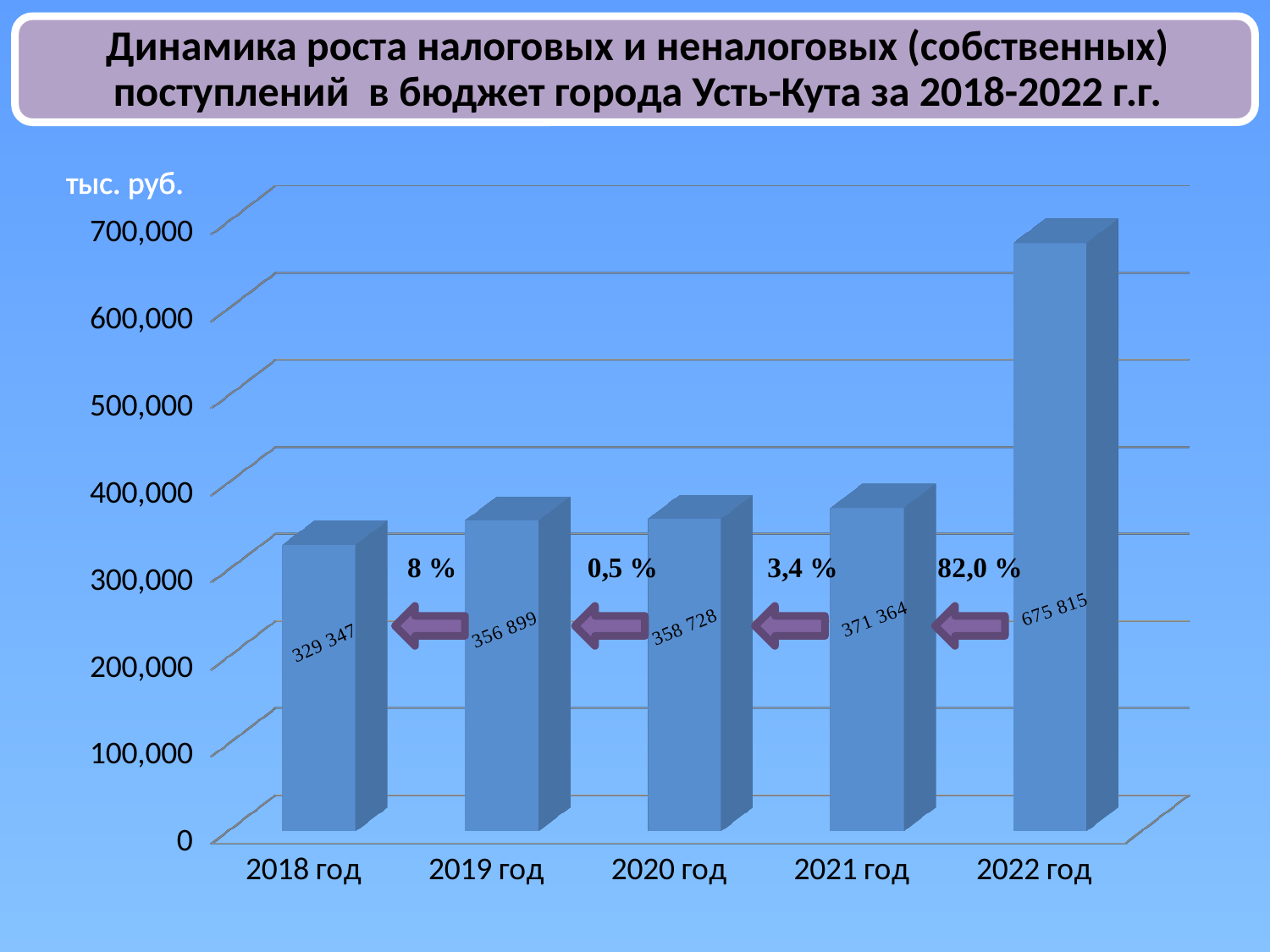
How many years are shown on the x axis? 5 What is the value for 2022 год? 675 815 What is the difference between the values for 2022 год and 2021 год? 304 451 What is the difference between the values for 2019 год and 2018 год? 27 552 Is the value for 2022 год greater or less than 600,000? greater Which year has the highest value? 2022 год Which year has the lowest value? 2018 год What is the value for 2020 год? 358 728 What is the value for 2018 год? 329 347 Which is larger, the value for 2021 год or the value for 2018 год? 2021 год What kind of chart is shown on the slide? bar chart What percentage growth is shown between 2021 год and 2022 год? 82,0 %